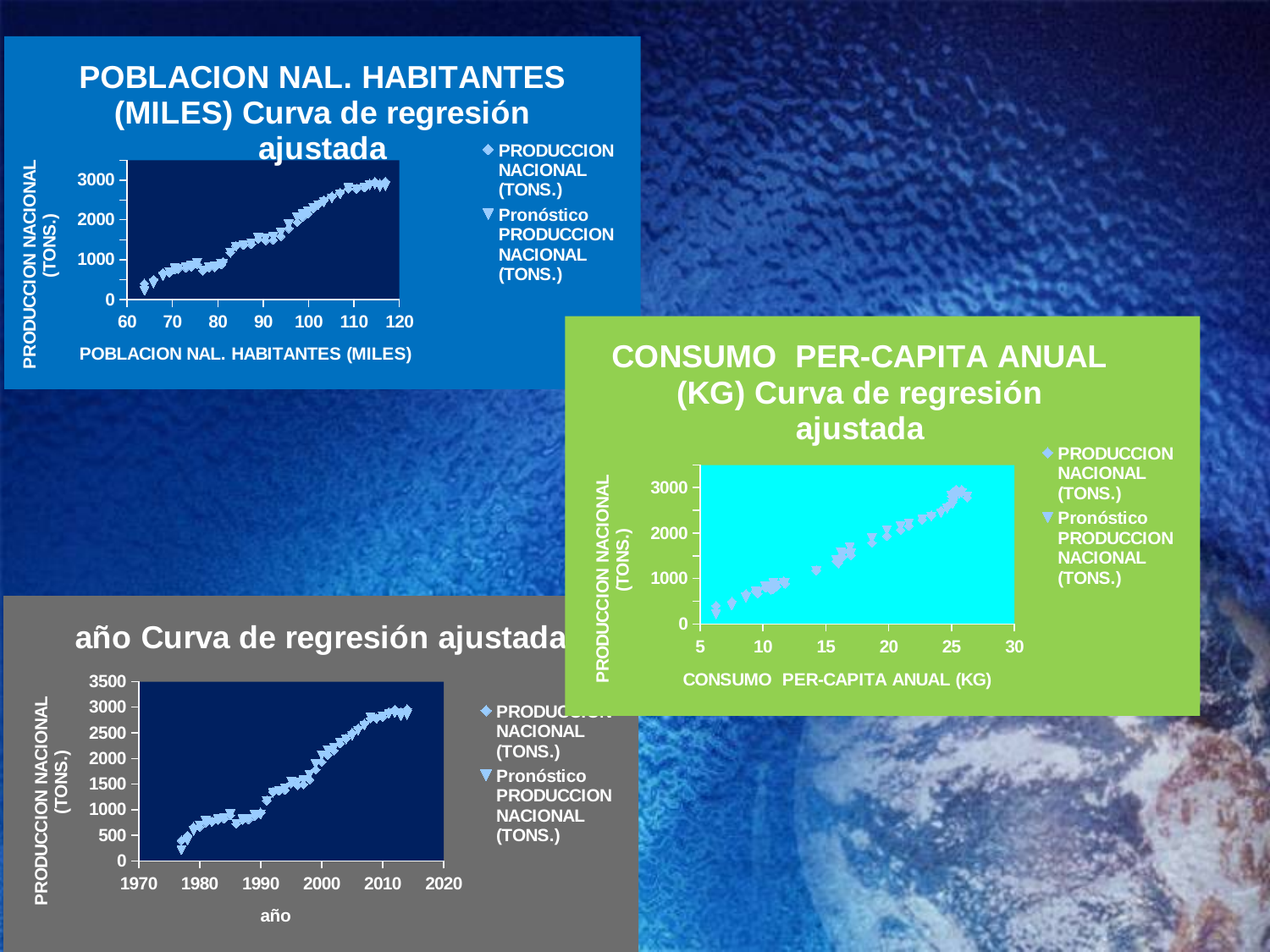
In the 'CONSUMO PER-CAPITA ANUAL (KG) Curva de regresión ajustada' chart, do the values rise or fall as consumption increases along the x axis? rise What kind of chart is the 'año Curva de regresión ajustada' chart at the bottom left? scatter chart In the 'CONSUMO PER-CAPITA ANUAL (KG) Curva de regresión ajustada' chart, is the production value at a consumption of 10 greater or less than 1000? less In the 'año Curva de regresión ajustada' chart, is the production value around the year 2010 greater or less than 2000? greater In the 'año Curva de regresión ajustada' chart, do the values rise or fall as the year increases along the x axis? rise What is the x-axis label of the 'año Curva de regresión ajustada' chart? año In the 'CONSUMO PER-CAPITA ANUAL (KG) Curva de regresión ajustada' chart, is the production value at a consumption of 25 greater or less than 2000? greater What is the y-axis label of the 'CONSUMO PER-CAPITA ANUAL (KG) Curva de regresión ajustada' chart? PRODUCCION NACIONAL (TONS.) How many series does the legend list for the 'POBLACION NAL. HABITANTES (MILES) Curva de regresión ajustada' chart? 2